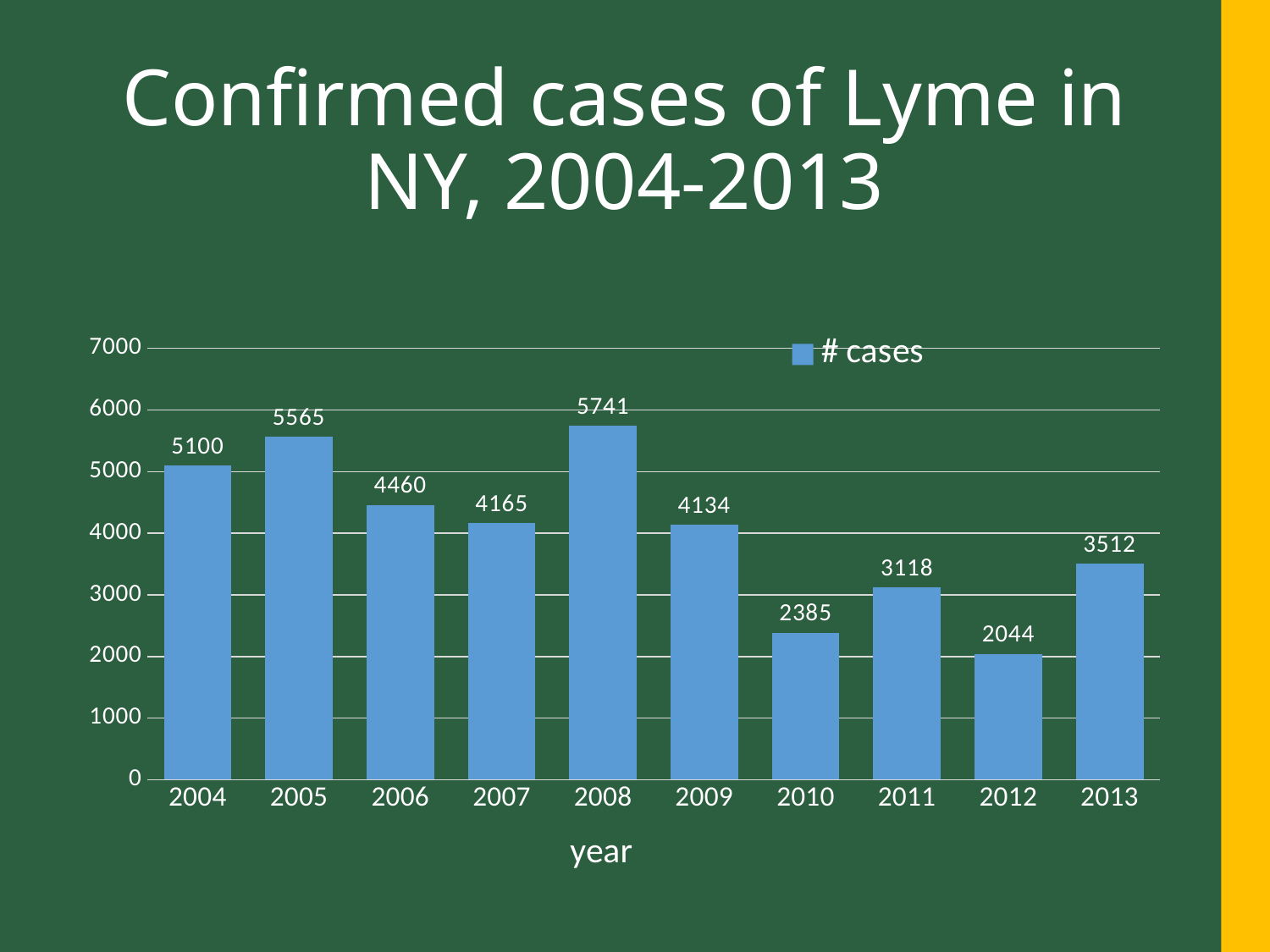
Which year has the lowest number of cases? 2012 Which year had more cases, 2010 or 2011? 2011 Is the value for 2009 greater or less than 4000? greater What is the number of cases shown for 2012? 2044 What value is shown for 2004? 5100 What is the difference in cases between 2005 and 2006? 1105 How many confirmed cases of Lyme were there in NY in 2008? 5741 What is the difference in cases between 2013 and 2012? 1468 What kind of chart is shown on the slide? Bar chart Which year has the highest number of cases? 2008 How many years are shown on the x axis? 10 How many series does the legend list? 1